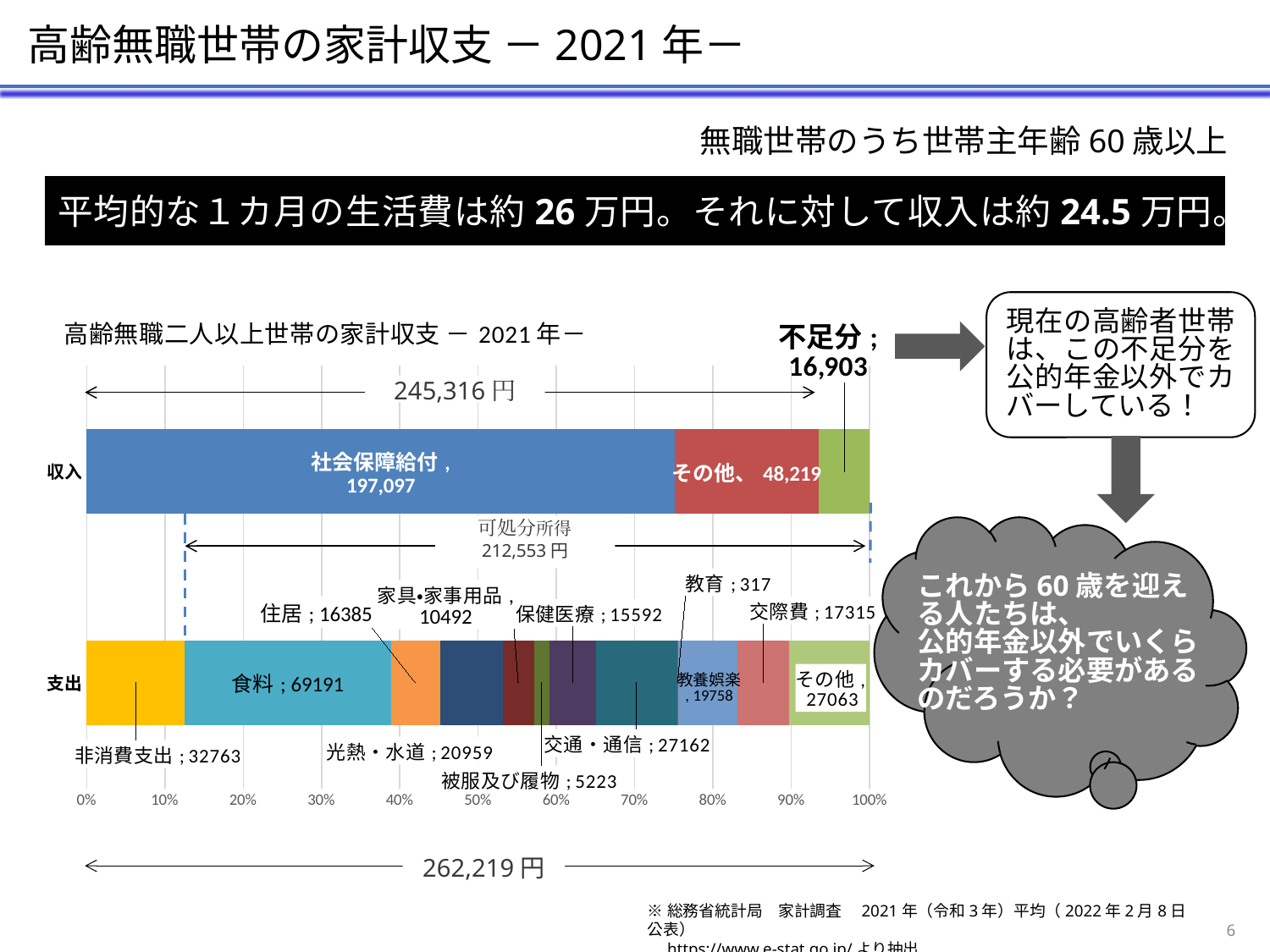
支出の棒はいくつの項目（セグメント）で構成されていますか？ 12 支出の「交通・通信」と「光熱・水道」では、どちらの値が大きいですか？ 交通・通信 このグラフのタイトルは何ですか？ 高齢無職二人以上世帯の家計収支 － 2021年－ グラフに示されている「可処分所得」の値はいくらですか？ 212,553 円 収入の棒で、「社会保障給付」と「その他」の差はいくらですか？ 148,878 収入の棒に示されている「不足分」の値はいくらですか？ 16,903 このグラフはどの種類のグラフですか？ 積み上げ棒グラフ（100%横棒） 収入の棒における「社会保障給付」の値はいくらですか？ 197,097 支出の棒における「食料」の値はいくらですか？ 69191 支出の合計額として示されている値はいくらですか？ 262,219 円 支出の棒の中で最も値が大きい項目はどれですか？ 食料 支出の棒の中で最も値が小さい項目はどれですか？ 教育